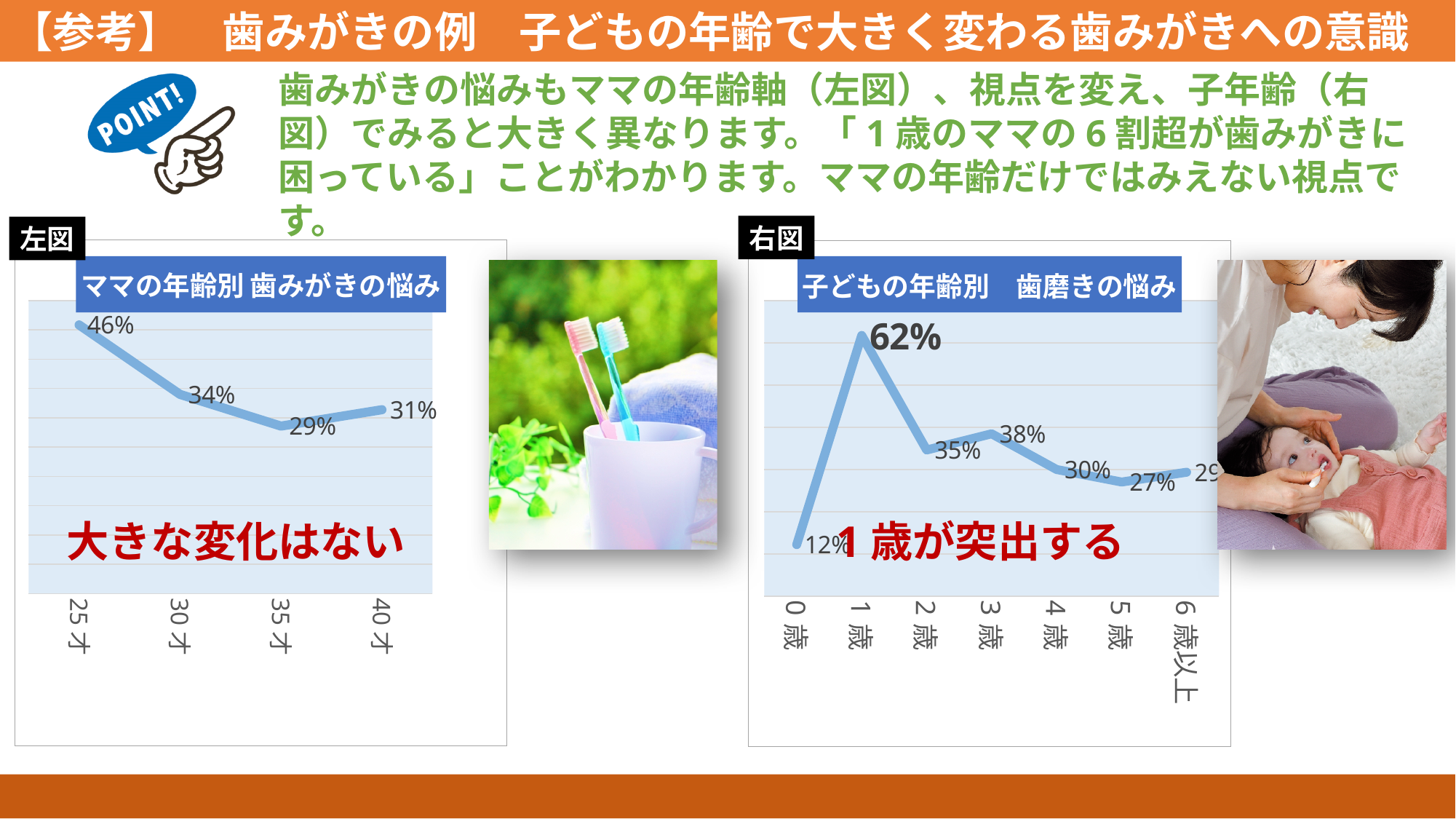
In the right chart (子どもの年齢別 歯磨きの悩み), what is the value for 1歳? 62% In the right chart (子どもの年齢別 歯磨きの悩み), what is the value for 0歳? 12% In the right chart (子どもの年齢別 歯磨きの悩み), which is larger, the value for 2歳 or the value for 3歳? 3歳 In the left chart (ママの年齢別 歯みがきの悩み), which age group has the lowest value? 35才 In the left chart (ママの年齢別 歯みがきの悩み), which age group has the highest value? 25才 In the left chart (ママの年齢別 歯みがきの悩み), what is the difference between the values for 25才 and 30才? 12% In the right chart (子どもの年齢別 歯磨きの悩み), what is the difference between the values for 1歳 and 2歳? 27% In the left chart (ママの年齢別 歯みがきの悩み), what is the value for 25才? 46% In the left chart (ママの年齢別 歯みがきの悩み), how many age categories are plotted? 4 In the left chart (ママの年齢別 歯みがきの悩み), what is the value for 35才? 29% What type of chart is used in the right chart (子どもの年齢別 歯磨きの悩み)? Line chart In the right chart (子どもの年齢別 歯磨きの悩み), which child age has the highest value? 1歳